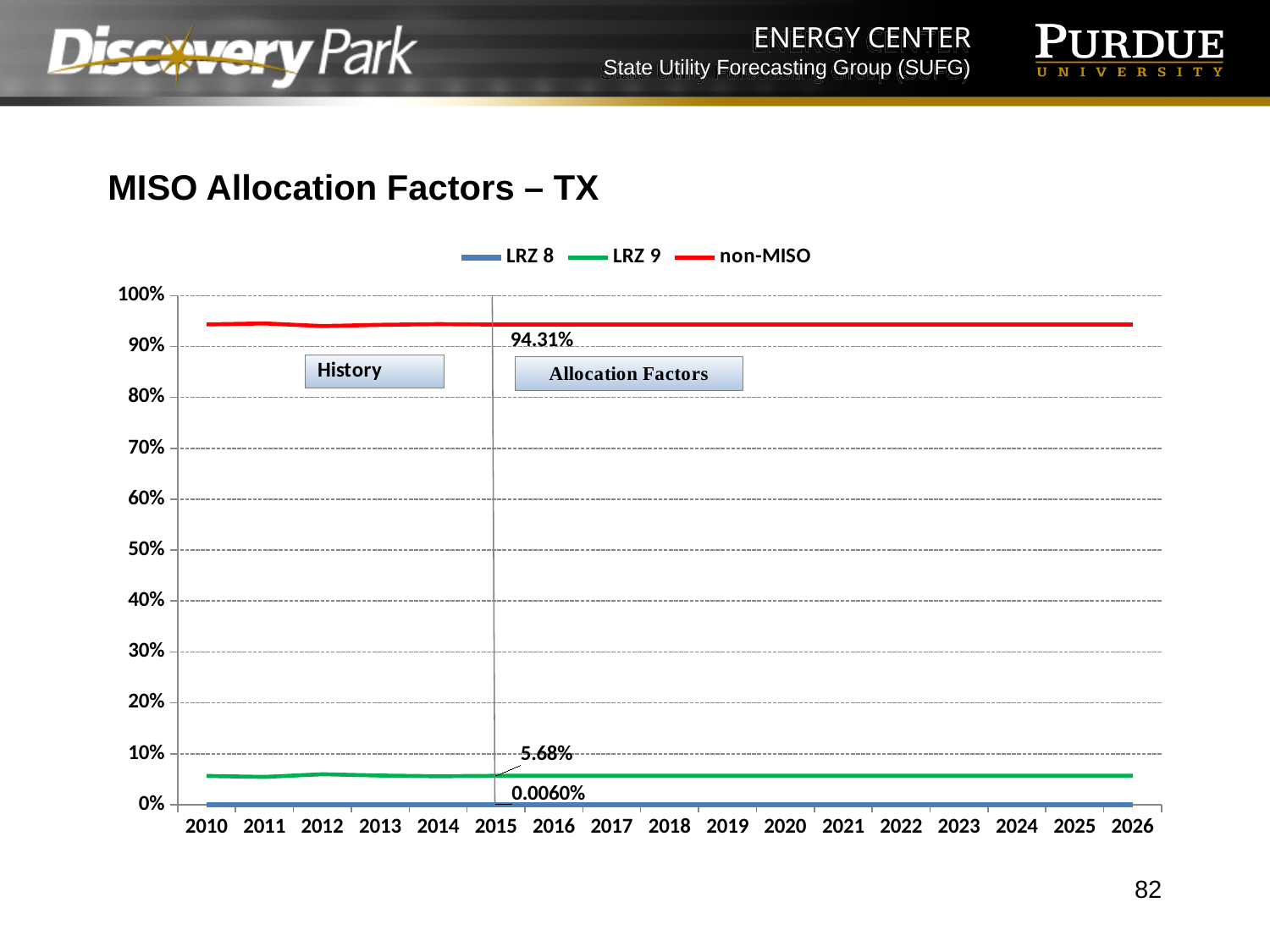
What is the title of the chart? MISO Allocation Factors – TX Is the value for non-MISO in 2020 greater or less than 90%? greater Which series has the lowest values across the chart? LRZ 8 What is the labelled value for LRZ 9 in 2015? 5.68% How many series does the legend list? 3 Which series has the highest values across the chart? non-MISO What is the difference between the 2015 labelled values for non-MISO and LRZ 9? 88.63% How many years are shown on the x axis? 17 Which is larger in 2015, the value for LRZ 9 or the value for LRZ 8? LRZ 9 What is the labelled value for non-MISO in 2015? 94.31% What is the labelled value for LRZ 8 in 2015? 0.0060% What kind of chart is shown on the slide? line chart